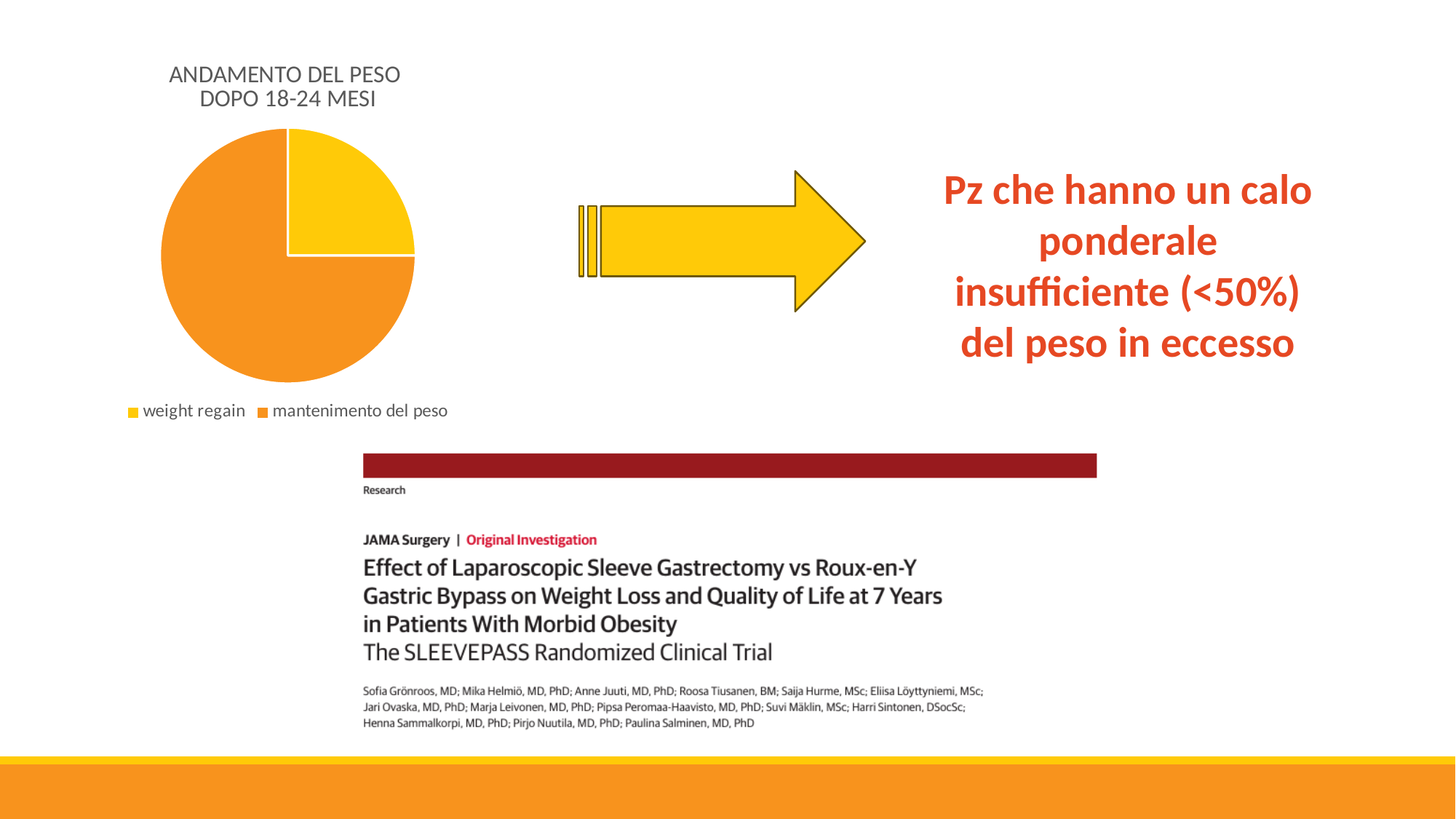
What is the title of the pie chart? ANDAMENTO DEL PESO DOPO 18-24 MESI What kind of chart is shown on the slide? pie chart Which category has the smallest slice in the pie chart? weight regain In the pie chart, which slice is larger: weight regain or mantenimento del peso? mantenimento del peso What colour is the slice for weight regain in the pie chart? yellow Which category has the largest slice in the pie chart? mantenimento del peso How many entries does the legend of the pie chart list? 2 How many slices does the pie chart have? 2